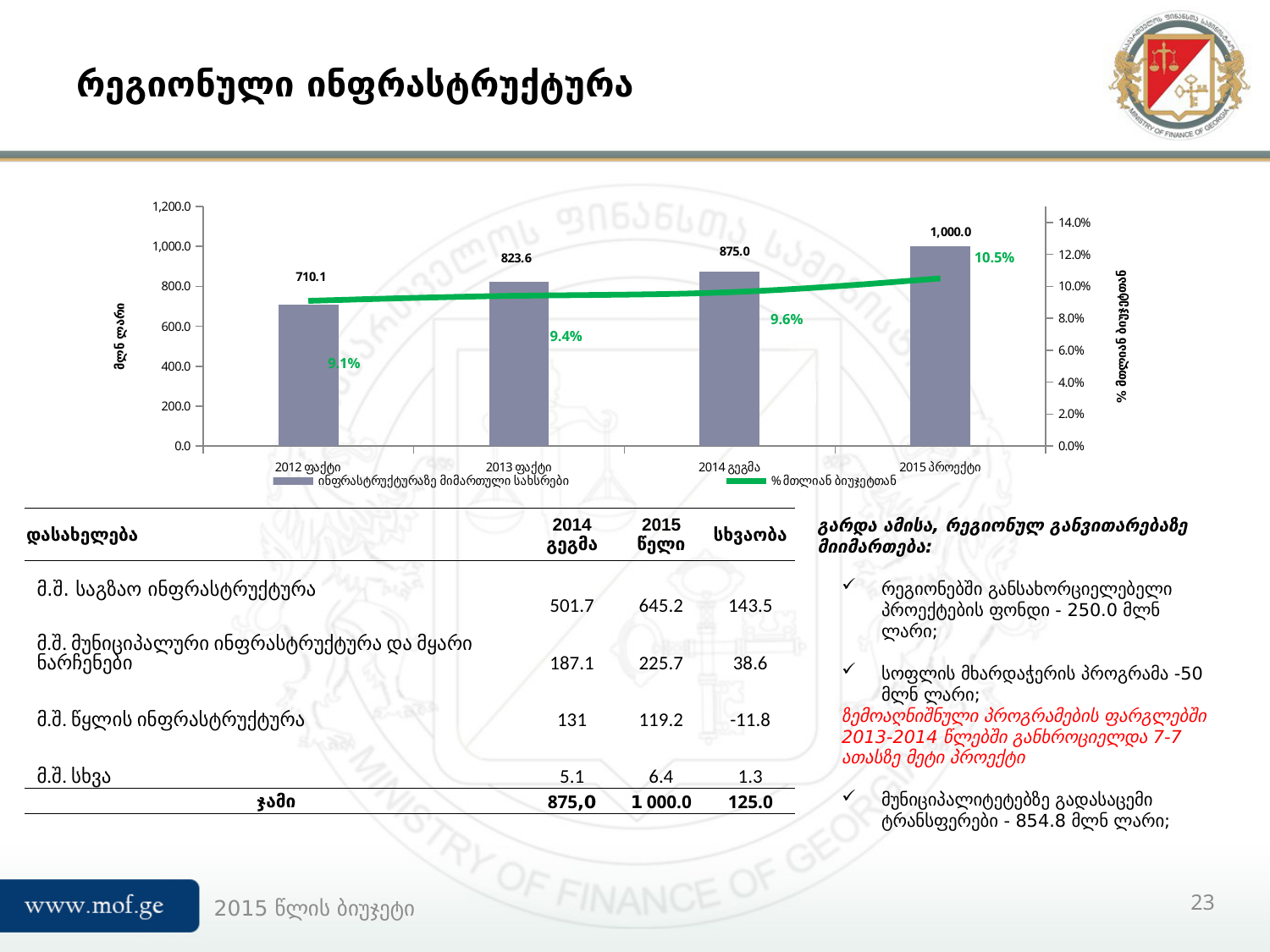
What is the difference between the bar values for 2015 პროექტი and 2014 გეგმა? 125.0 Which category has the highest bar value? 2015 პროექტი Which is larger, the bar value for 2013 ფაქტი or for 2014 გეგმა? 2014 გეგმა What percentage (% მთლიან ბიუჯეტთან) is shown for 2014 გეგმა? 9.6% What colour is the line series (% მთლიან ბიუჯეტთან) in the chart? green Do the percentage values on the line rise or fall from 2012 ფაქტი to 2015 პროექტი? rise Which category has the lowest bar value? 2012 ფაქტი How many categories are shown on the x axis of the chart? 4 What is the bar value for 2015 პროექტი? 1,000.0 What is the bar value for 2012 ფაქტი? 710.1 What percentage (% მთლიან ბიუჯეტთან) is shown for 2013 ფაქტი? 9.4% How many series does the chart legend list? 2